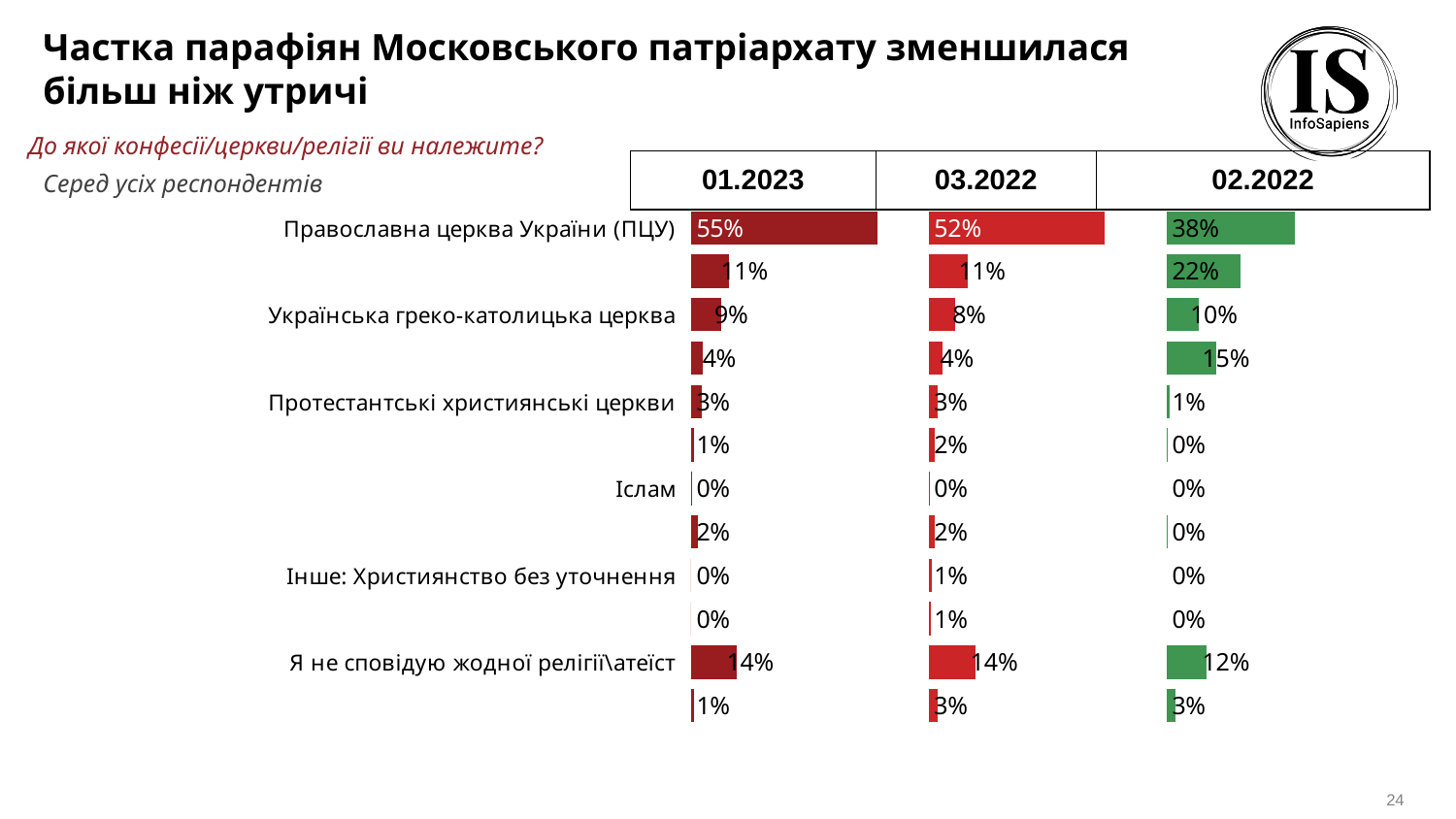
In the 02.2022 chart, what is the value for Православна церква України (ПЦУ)? 38% In the 01.2023 chart, which labeled category has the highest value? Православна церква України (ПЦУ) In the 01.2023 chart, what is the value for Православна церква України (ПЦУ)? 55% What is the difference between the value for Православна церква України (ПЦУ) in the 01.2023 chart and in the 02.2022 chart? 17% In the 03.2022 chart, what is the value for Українська греко-католицька церква? 8% Which is larger: the value for Українська греко-католицька церква in the 01.2023 chart or in the 02.2022 chart? 02.2022 How many time periods (charts) are shown on the slide? 3 In the 02.2022 chart, what is the value for Протестантські християнські церкви? 1% What colour are the bars in the 02.2022 chart? Green In the 03.2022 chart, what is the value for Інше: Християнство без уточнення? 1% In the 01.2023 chart, what is the value for Я не сповідую жодної релігії\атеїст? 14% What kind of chart is used on the slide? Bar chart